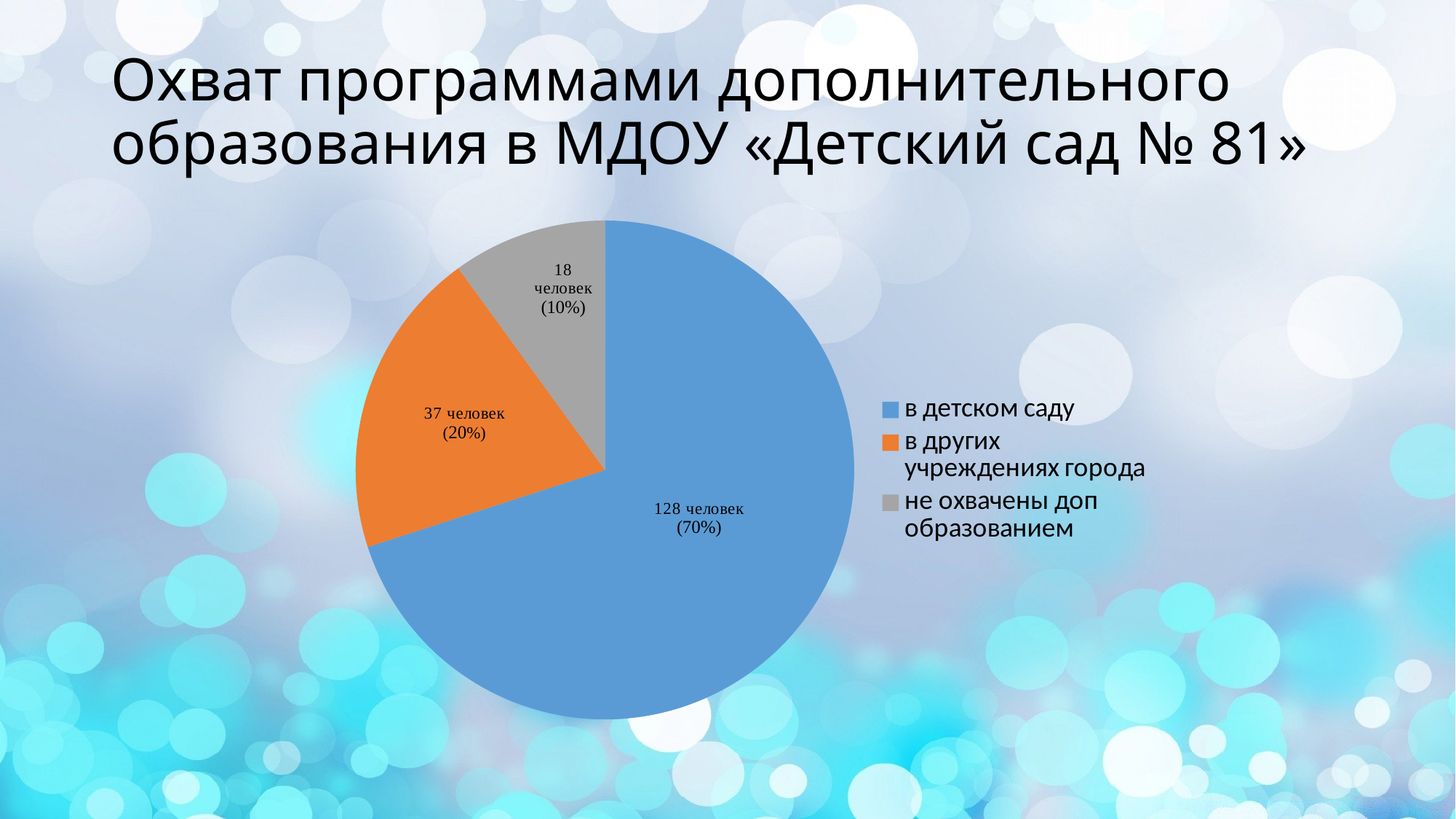
What is the difference in people between 'в детском саду' and 'в других учреждениях города'? 91 человек Which is larger: 'в других учреждениях города' or 'не охвачены доп образованием'? в других учреждениях города How many people are in the 'не охвачены доп образованием' slice? 18 человек What kind of chart is shown on the slide? pie chart How many people are in the 'в других учреждениях города' slice? 37 человек What share of the pie does 'не охвачены доп образованием' take? 10% How many categories does the pie chart have? 3 Which category has the smallest slice? не охвачены доп образованием How many people are in the 'в детском саду' slice? 128 человек Which category has the largest slice? в детском саду What colour is the 'в других учреждениях города' slice? orange What share of the pie does 'в детском саду' take? 70%